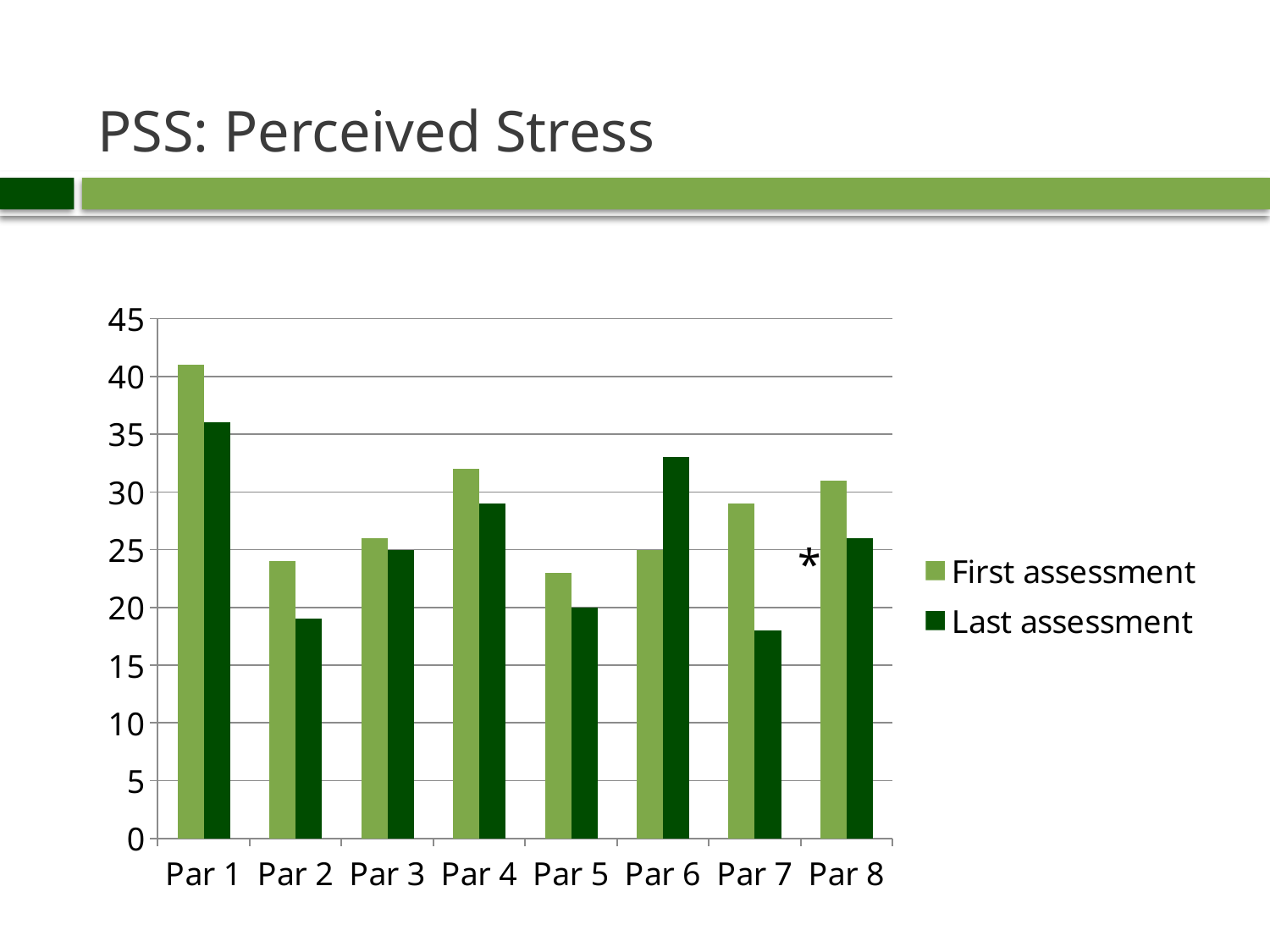
What is the title of the slide containing the chart? PSS: Perceived Stress Is the First assessment value for Par 4 greater or less than 30? greater How many series does the legend list? 2 Is the Last assessment value for Par 7 greater or less than 20? less For Par 7, which is larger: the First assessment or the Last assessment? First assessment What kind of chart is shown on the slide? bar chart How many participants (categories) are shown on the x axis? 8 For Par 6, which is larger: the First assessment or the Last assessment? Last assessment Which participant has the highest Last assessment value? Par 1 Is the Last assessment value for Par 6 greater or less than 30? greater Which participant has the highest First assessment value? Par 1